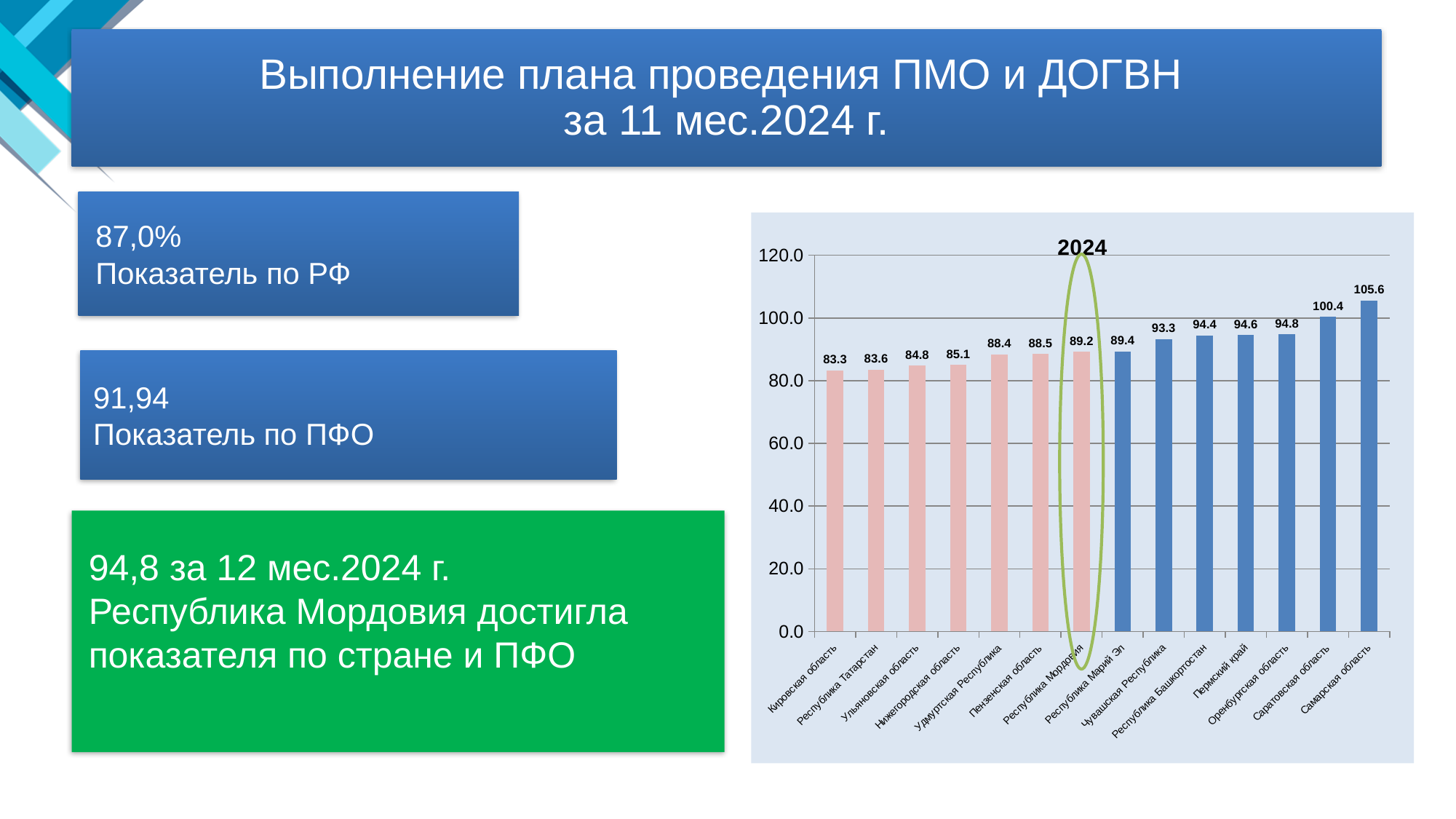
Is the value for Саратовская область greater or less than 100.0? greater Which category has the lowest value in the chart? Кировская область What is the title of the chart? 2024 What is the value shown for Республика Мордовия in the chart? 89.2 Do the values rise or fall from left to right along the x axis? Rise Which category has the highest value in the chart? Самарская область What is the value shown for Кировская область in the chart? 83.3 Which is larger: the value for Чувашская Республика or the value for Пензенская область? Чувашская Республика What is the value shown for Самарская область in the chart? 105.6 What kind of chart is shown on the slide? Bar chart How many categories (regions) are plotted in the chart? 14 What is the difference between the values for Самарская область and Саратовская область? 5.2